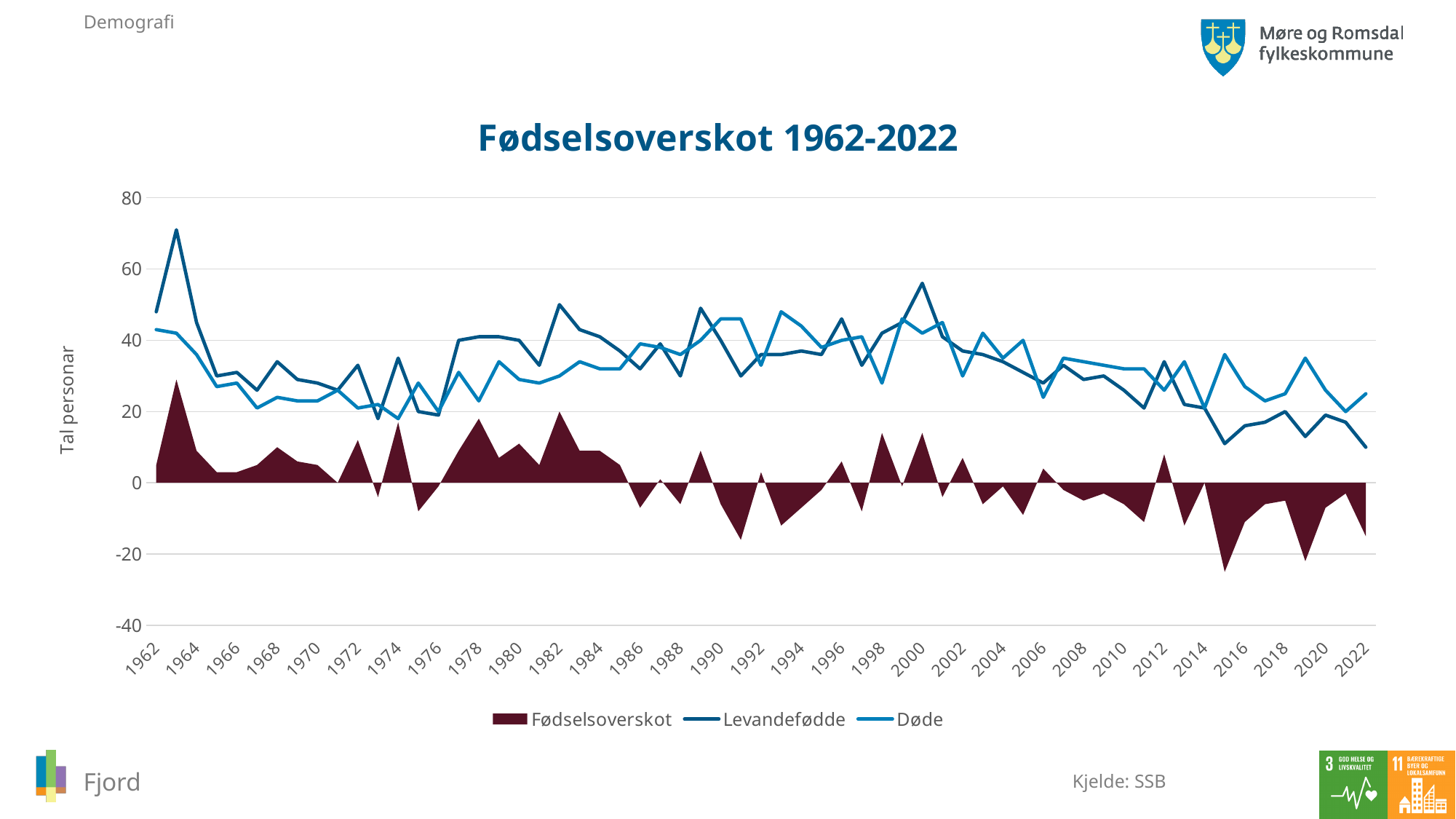
In 1963, which is larger: Levandefødde or Døde? Levandefødde Is the value for Fødselsoverskot in 2015 greater or less than 0? less Is the value for Levandefødde in 1963 greater or less than 60? greater What are the three series named in the legend? Fødselsoverskot, Levandefødde, Døde Is the value for Døde in 1966 greater or less than 40? less What is the title of the chart? Fødselsoverskot 1962-2022 In 2022, which is larger: Levandefødde or Døde? Døde How many series does the legend list? 3 Does the Levandefødde series overall rise or fall from 1962 to 2022? fall In which year does the Levandefødde series reach its highest value? 1963